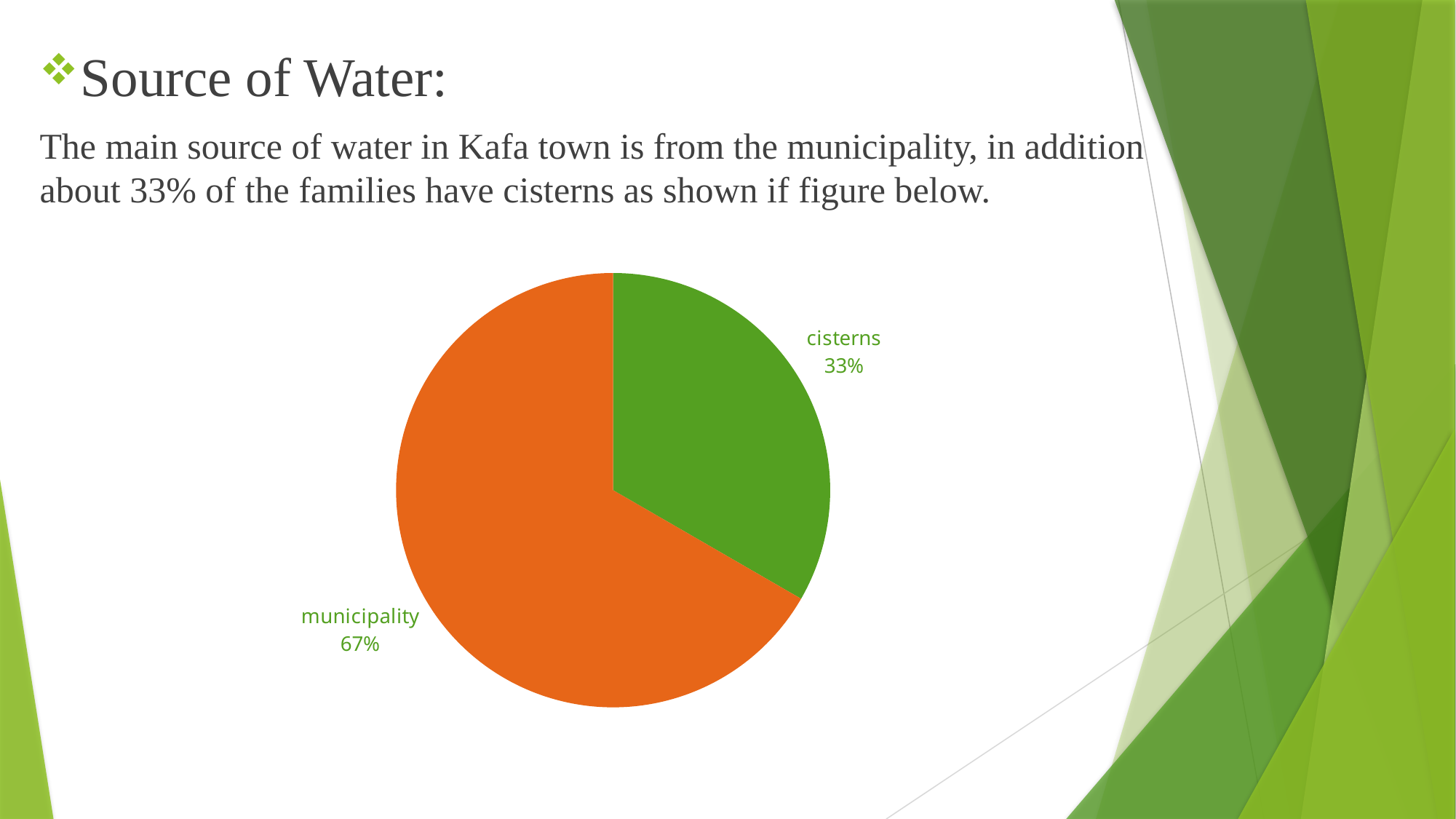
What is the difference in percentage points between the municipality slice and the cisterns slice? 34% What colour is the municipality slice? orange How many slices does the pie chart have? 2 Which category has the largest slice of the pie? municipality Which is larger, the municipality slice or the cisterns slice? municipality What colour is the cisterns slice? green What kind of chart is shown on the slide? pie chart What share of the pie does municipality represent? 67% Which category has the smallest slice of the pie? cisterns What share of the pie does cisterns represent? 33%